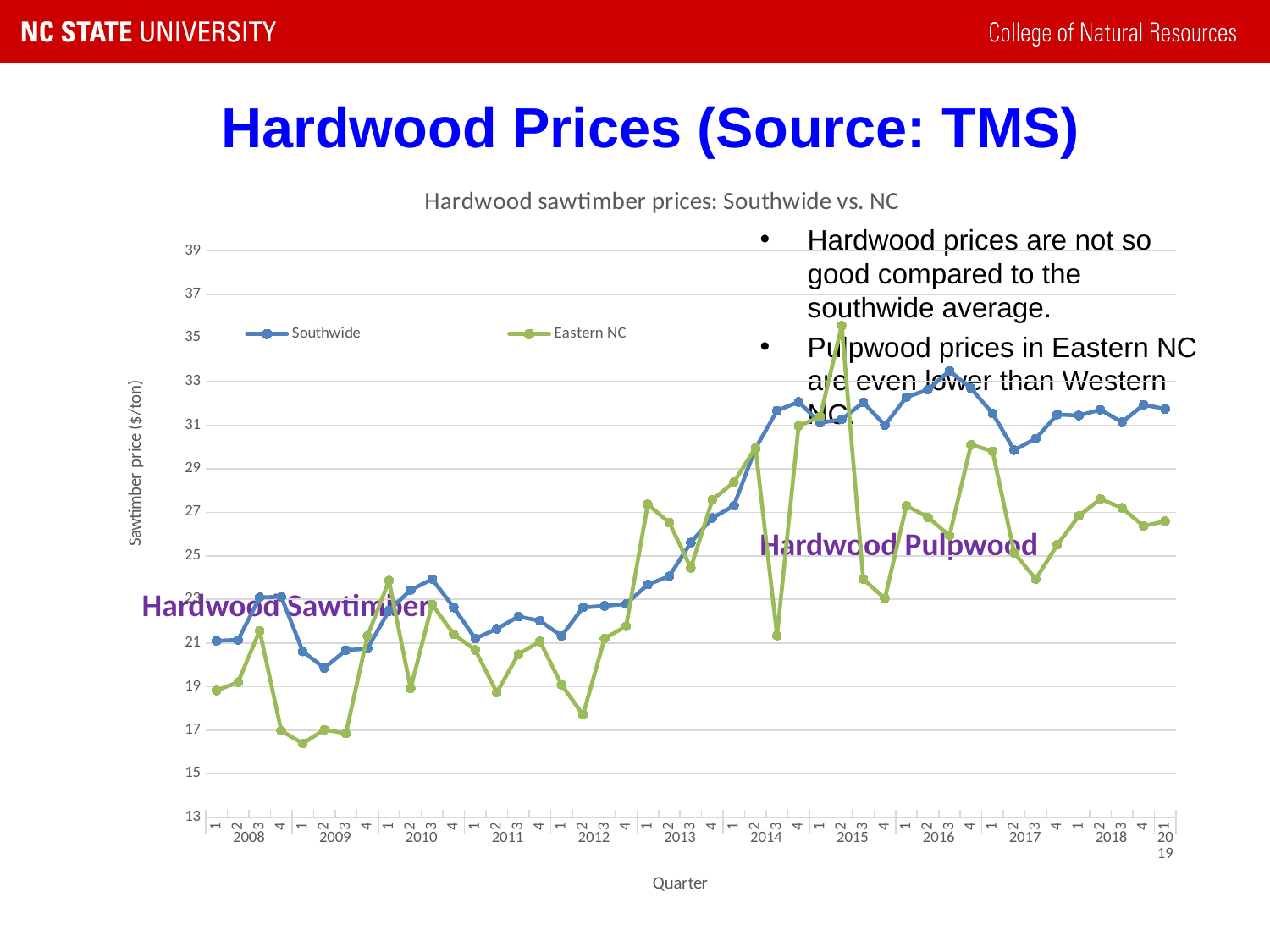
Is the Eastern NC value in quarter 2 of 2012 greater or less than 19? less Is the Eastern NC value in quarter 2 of 2015 greater or less than 33? greater What is the label on the vertical axis of the chart? Sawtimber price ($/ton) How many series does the chart legend list? 2 What are the two series named in the chart legend? Southwide and Eastern NC What kind of chart is shown on the slide? Line chart Overall, do the Southwide prices rise or fall from 2008 to 2019? Rise In which quarter does the Eastern NC series reach its lowest value? Quarter 1 of 2009 Is the Southwide value in quarter 3 of 2016 greater or less than 31? greater In quarter 1 of 2009, which series has the higher value, Southwide or Eastern NC? Southwide In quarter 2 of 2015, which series has the higher value, Southwide or Eastern NC? Eastern NC In which quarter does the Eastern NC series reach its highest value? Quarter 2 of 2015